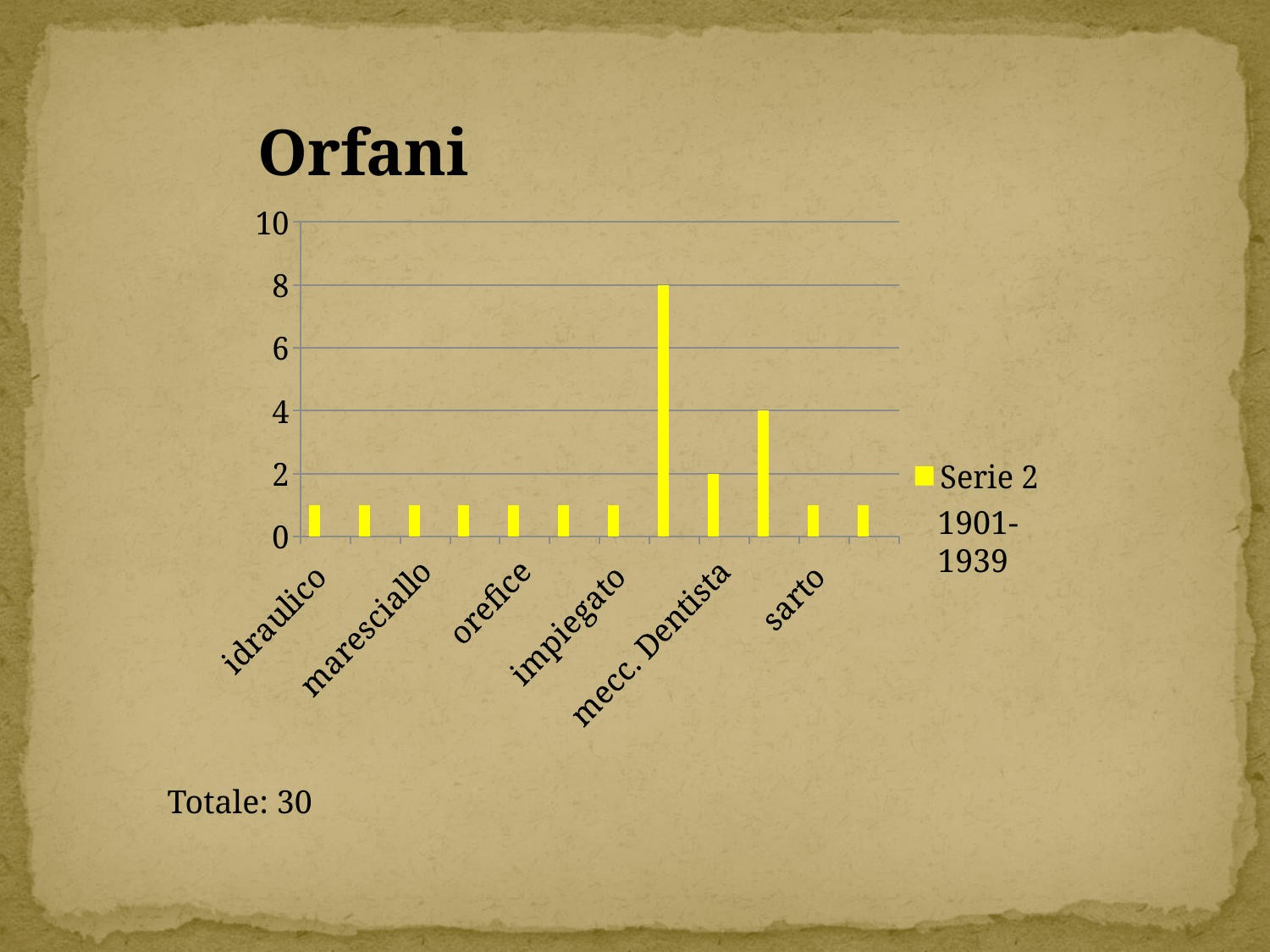
Is the value for impiegato greater or less than 2? less Is the value for sarto greater or less than 2? less Which is larger, the value for mecc. Dentista or the value for orefice? mecc. Dentista What kind of chart is shown on the slide? bar chart What is the name of the series shown in the legend? Serie 2 Is the value for idraulico greater or less than 2? less What is the title of the chart? Orfani Which is larger, the value for mecc. Dentista or the value for sarto? mecc. Dentista How many series does the legend list? 1 How many bars are plotted in the chart? 12 What is the value for mecc. Dentista? 2